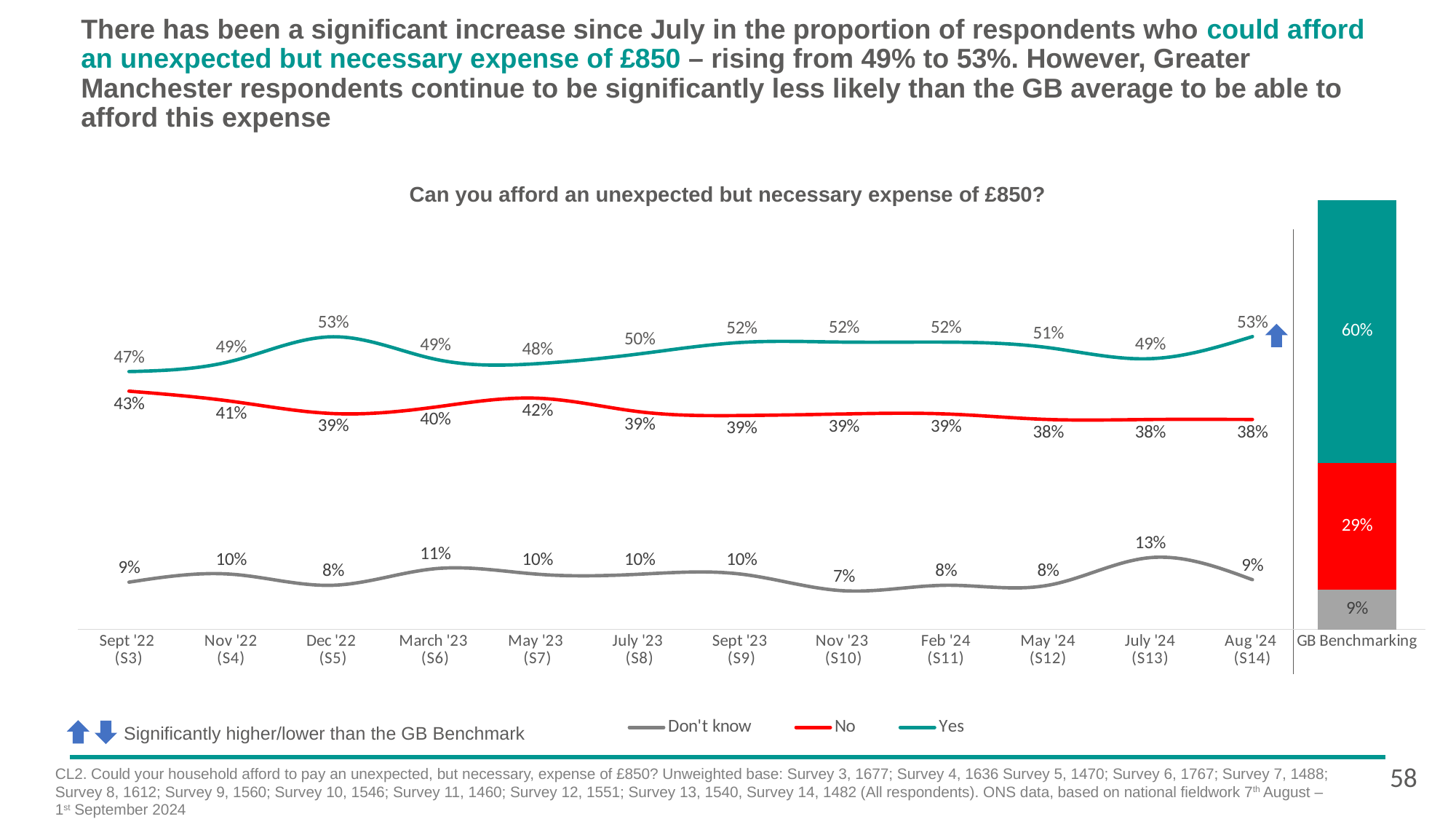
In May '23 (S7), which is larger: the Yes value or the No value? Yes What is the difference between the Yes and No values in Aug '24 (S14)? 15 percentage points At which survey wave is the Don't know line at its highest? July '24 (S13) How many series does the legend list? 3 What is the Yes value in the GB Benchmarking bar? 60% What percentage of respondents answered Yes in Aug '24 (S14)? 53% How many survey waves are plotted on the x axis of the line chart (excluding GB Benchmarking)? 12 What colour is the Yes line? Teal/green What percentage of respondents answered No in Sept '22 (S3)? 43% At which survey wave is the Yes line at its lowest? Sept '22 (S3) What is the Don't know value for July '24 (S13)? 13% At which survey wave is the No line at its highest? Sept '22 (S3)